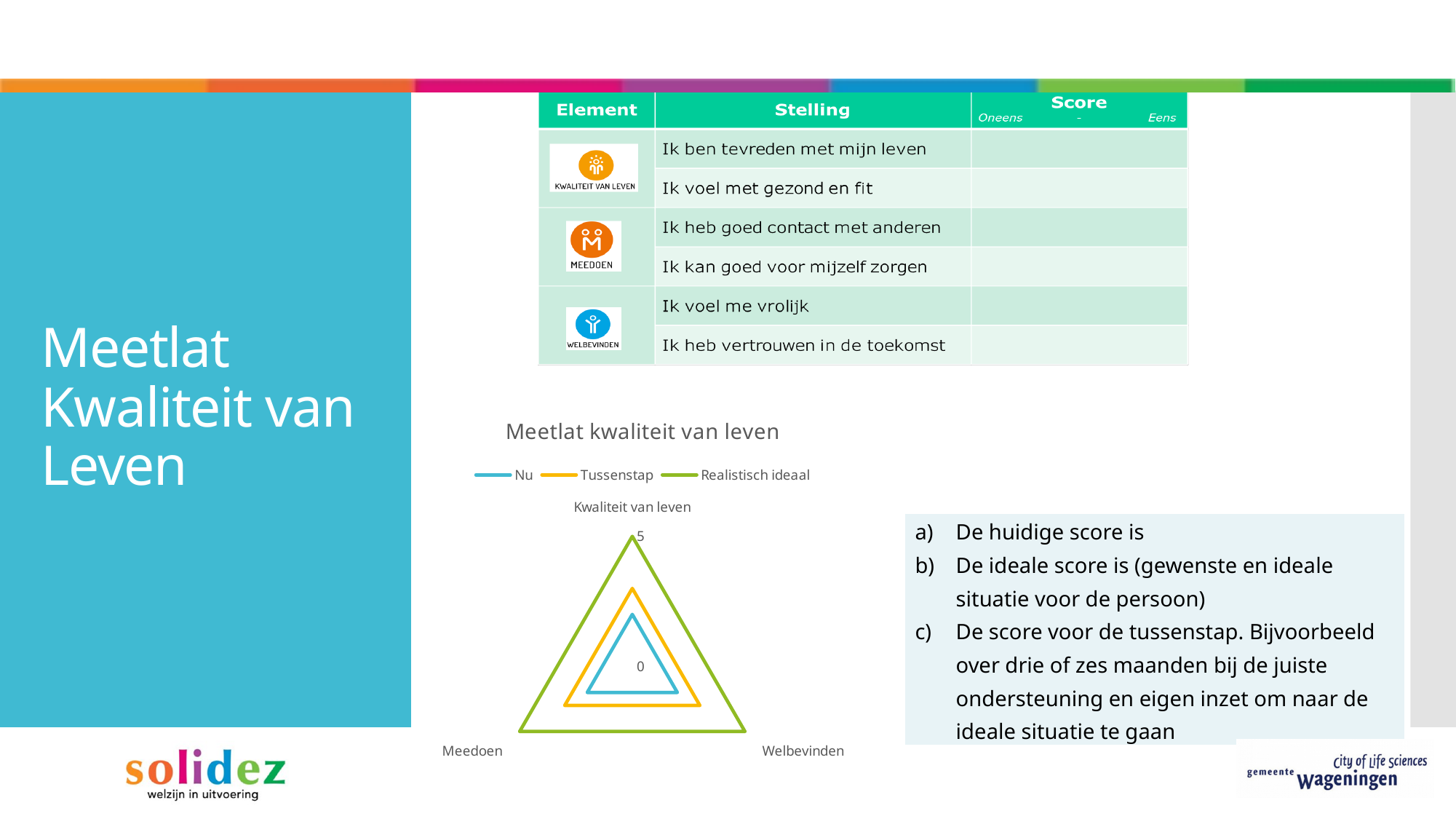
What kind of chart is shown on the slide? Radar chart How many series does the chart's legend list? 3 How many axes (categories) does the radar chart have? 3 What is the value for Realistisch ideaal on the Kwaliteit van leven axis? 5 Is the value for Nu on the Kwaliteit van leven axis greater or less than 5? less On the Kwaliteit van leven axis, which is larger: the value for Realistisch ideaal or the value for Tussenstap? Realistisch ideaal Which series is drawn in green in the chart? Realistisch ideaal On the Meedoen axis, which is larger: the value for Tussenstap or the value for Nu? Tussenstap What is the title of the chart? Meetlat kwaliteit van leven Which series has the lowest value on the Kwaliteit van leven axis? Nu Which series has the highest value on the Welbevinden axis? Realistisch ideaal Is the value for Tussenstap on the Welbevinden axis greater or less than 5? less